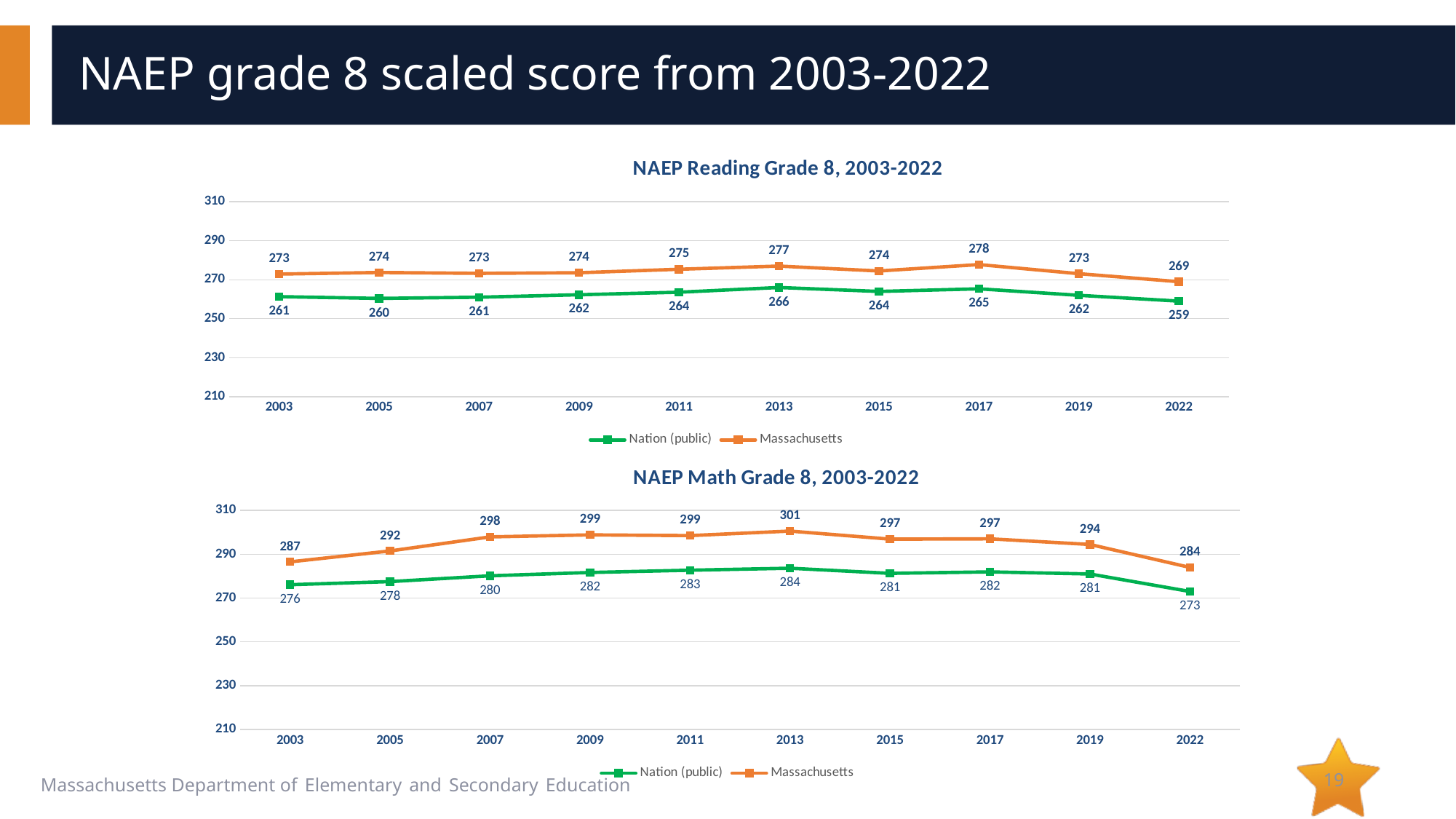
In the NAEP Math Grade 8 chart, in which year was the Nation (public) score lowest? 2022 In the NAEP Reading Grade 8 chart, what is the difference between the Massachusetts and Nation (public) scores in 2022? 10 In the NAEP Math Grade 8 chart, what was the Nation (public) score in 2007? 280 In the NAEP Reading Grade 8 chart, in which year was the Massachusetts score highest? 2017 How many series does the legend of the NAEP Reading Grade 8 chart list? 2 In the NAEP Math Grade 8 chart, what was the Massachusetts score in 2013? 301 What type of chart is the NAEP Math Grade 8 chart? Line chart In the NAEP Reading Grade 8 chart, what was the Nation (public) score in 2022? 259 In the NAEP Math Grade 8 chart, what is the difference between the Massachusetts scores in 2019 and 2022? 10 In the NAEP Math Grade 8 chart, which series had the higher score in 2003, Nation (public) or Massachusetts? Massachusetts In the NAEP Reading Grade 8 chart, what was the Massachusetts score in 2013? 277 In the NAEP Reading Grade 8 chart, how many years are shown on the x axis? 10